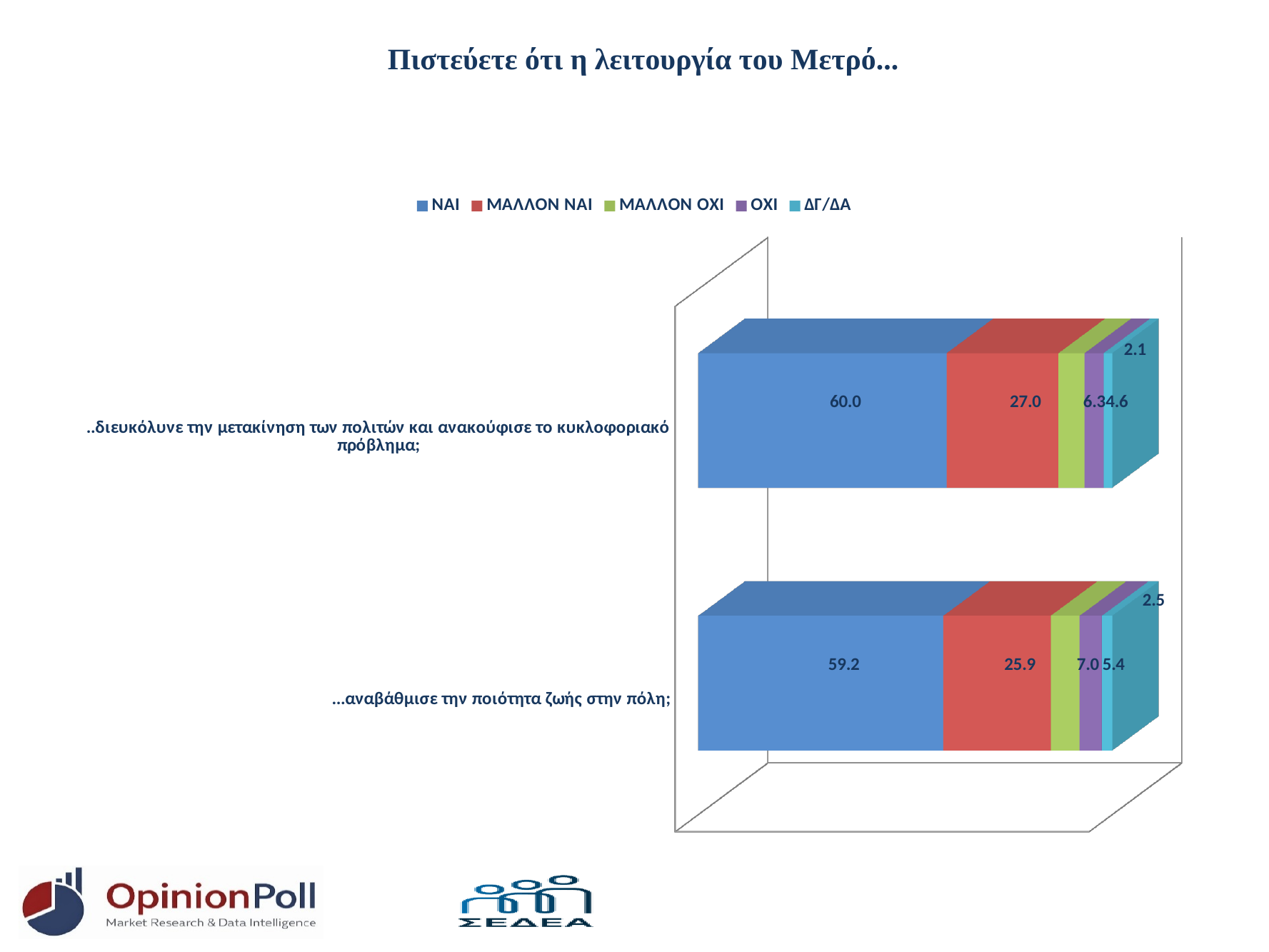
What is the value of ΜΑΛΛΟΝ ΟΧΙ for the category '...αναβάθμισε την ποιότητα ζωής στην πόλη;'? 7.0 What is the value of ΜΑΛΛΟΝ ΝΑΙ for the category '...αναβάθμισε την ποιότητα ζωής στην πόλη;'? 25.9 What is the difference between the ΝΑΙ values of the two categories? 0.8 How many series does the legend list? 5 Which series has the highest value for the category '...αναβάθμισε την ποιότητα ζωής στην πόλη;'? ΝΑΙ What is the value of ΔΓ/ΔΑ for the category '..διευκόλυνε την μετακίνηση των πολιτών και ανακούφισε το κυκλοφοριακό πρόβλημα;'? 2.1 What kind of chart is shown on the slide? Stacked bar chart How many categories (bars) are plotted in the chart? 2 What is the value of ΟΧΙ for the category '...αναβάθμισε την ποιότητα ζωής στην πόλη;'? 5.4 Which series has the lowest value for the category '..διευκόλυνε την μετακίνηση των πολιτών και ανακούφισε το κυκλοφοριακό πρόβλημα;'? ΔΓ/ΔΑ What is the total of the stacked bar for '...αναβάθμισε την ποιότητα ζωής στην πόλη;'? 100.0 What is the value of ΝΑΙ for the category '..διευκόλυνε την μετακίνηση των πολιτών και ανακούφισε το κυκλοφοριακό πρόβλημα;'? 60.0